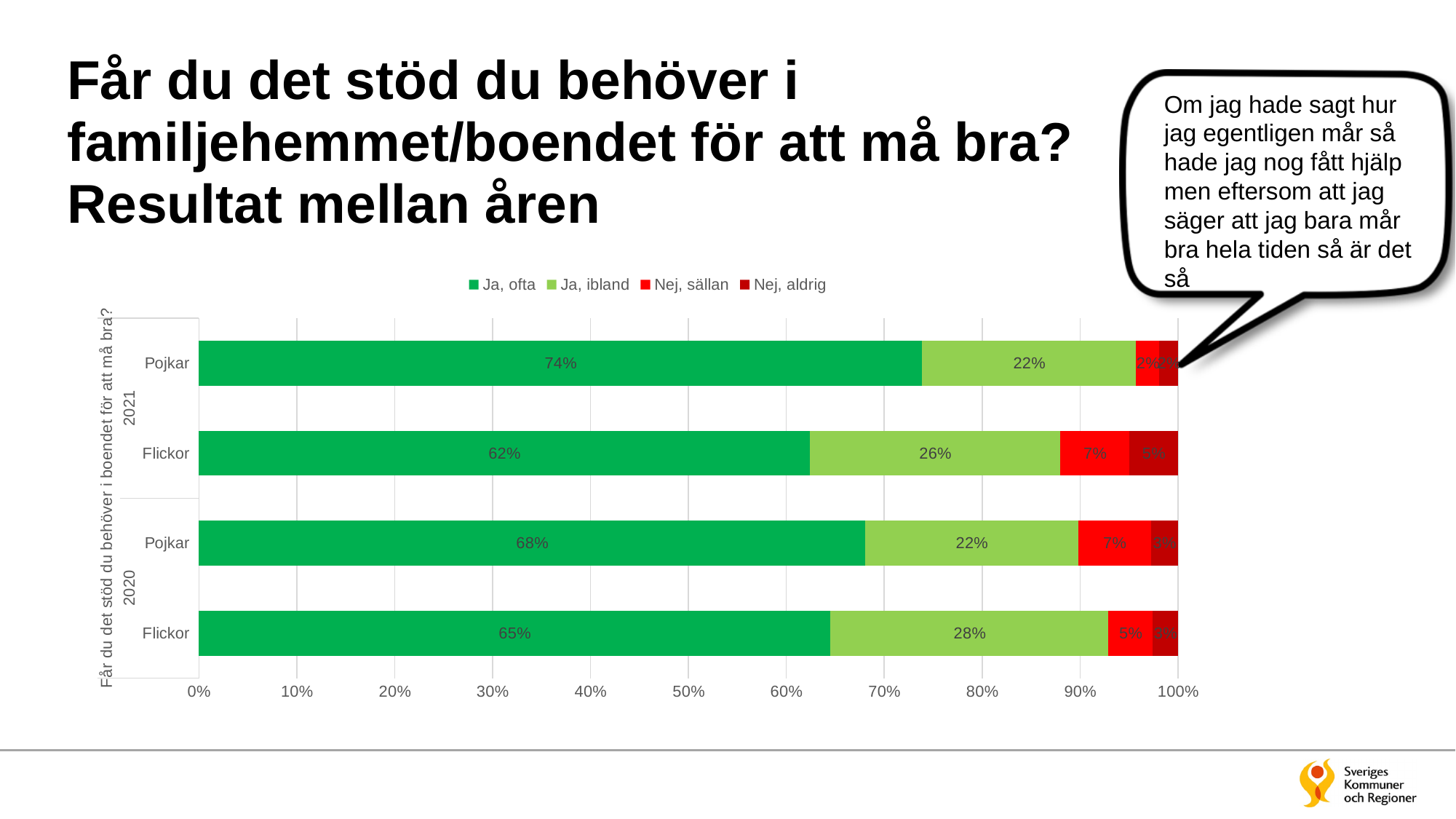
Which is larger: the 'Ja, ibland' value for Flickor in 2020 or for Flickor in 2021? Flickor 2020 What is the 'Nej, sällan' value for Pojkar in 2020? 7% Which group and year has the highest 'Ja, ofta' value? Pojkar 2021 Which group and year has the lowest 'Ja, ofta' value? Flickor 2021 What is the 'Ja, ofta' value for Pojkar in 2021? 74% What is the 'Nej, aldrig' value for Flickor in 2020? 3% Which legend entry is shown in dark red? Nej, aldrig How many bars (group-year categories) are shown in the chart? 4 How many series does the legend list? 4 What is the difference between the 'Ja, ofta' value for Pojkar in 2021 and Pojkar in 2020? 6 percentage points What kind of chart is shown on the slide? Stacked bar chart What is the 'Ja, ibland' value for Flickor in 2021? 26%